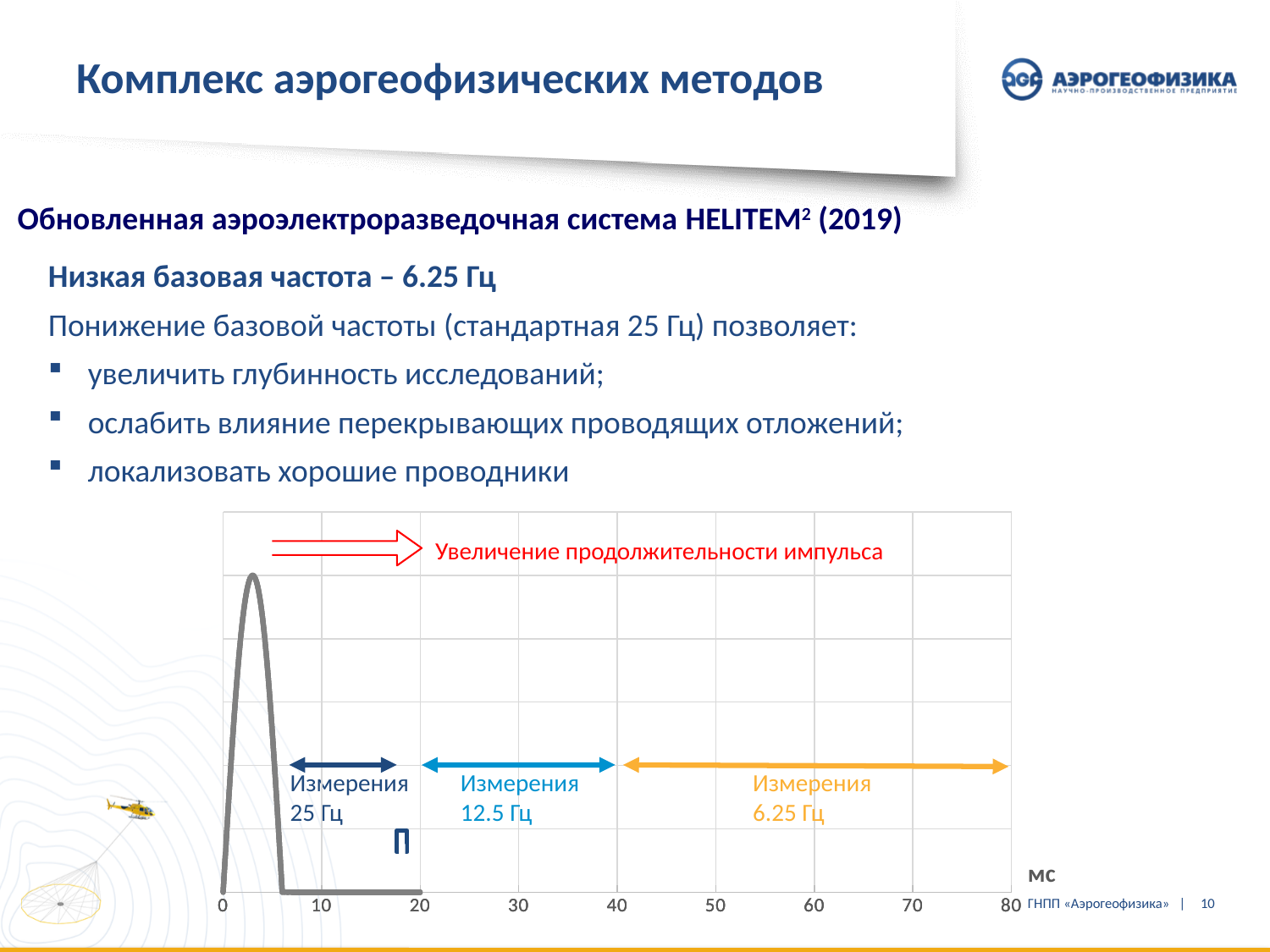
How many tick labels are printed along the x axis of the chart? 9 Which measurement interval is wider on the chart: 12.5 Гц or 25 Гц? 12.5 Гц What kind of chart is shown on the slide? line chart Which measurement interval on the chart spans the shortest range along the x axis? Измерения 25 Гц Does the plotted pulse curve rise or fall between 0 and about 3 мс on the x axis? rise Which measurement interval on the chart spans the longest range along the x axis? Измерения 6.25 Гц How many measurement intervals ("Измерения") are marked with arrows on the chart? 3 What is the highest value labelled on the x axis of the chart? 80 Is the end of the 25 Гц measurement interval on the chart greater or less than 20 мс? less What unit is shown on the x axis of the chart? мс What does the red arrow annotation at the top of the chart say? Увеличение продолжительности импульса What is the lowest value labelled on the x axis of the chart? 0